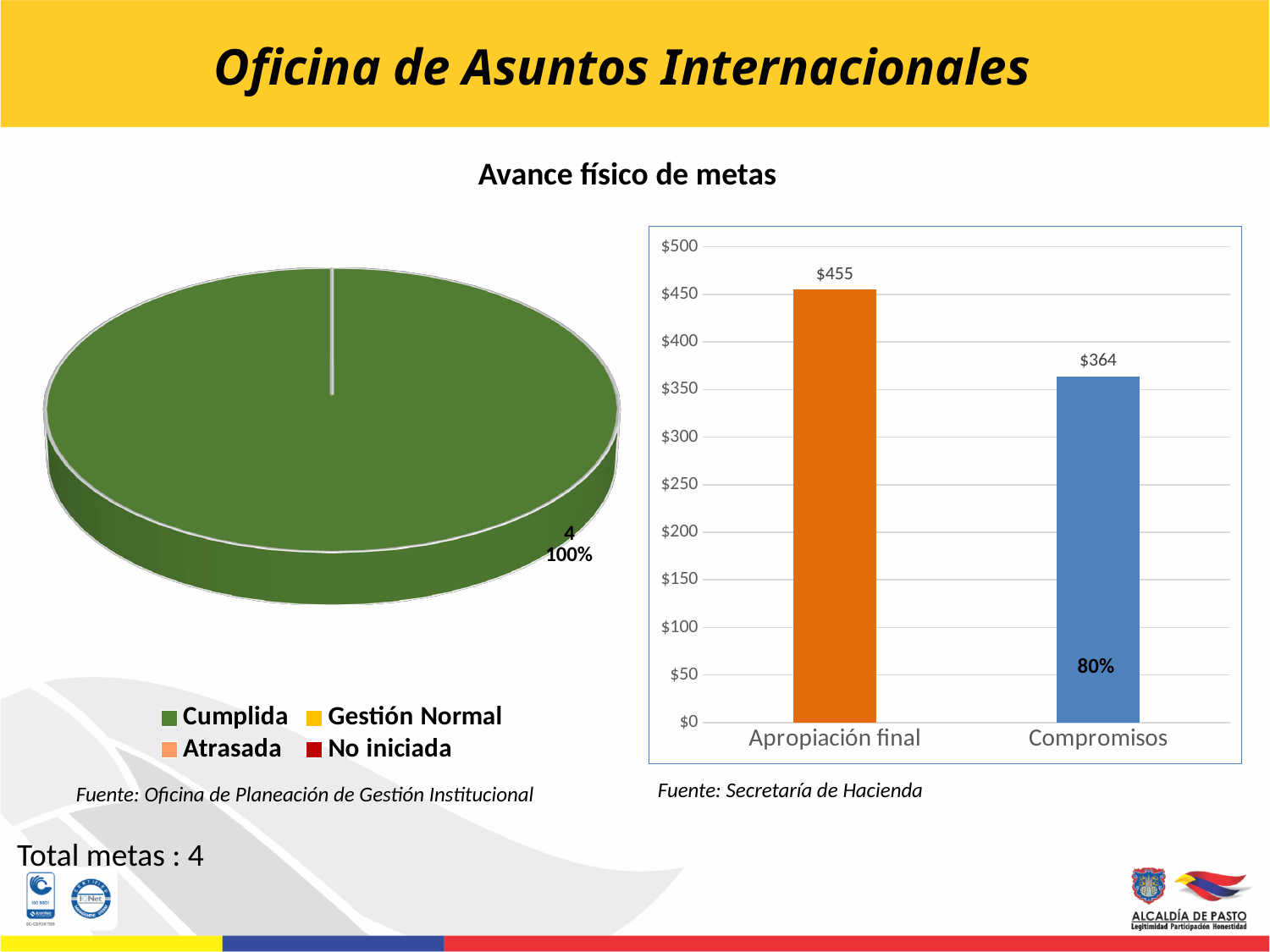
How many entries does the legend of the pie chart on the left list? 4 In the bar chart on the right, what is the value for Compromisos? $364 In the pie chart on the left, what value is labelled on the Cumplida slice? 4 In the bar chart on the right, is the value for Compromisos greater or less than $400? less In the bar chart on the right, how many categories are shown on the x axis? 2 In the bar chart on the right, what is the difference between Apropiación final and Compromisos? $91 What kind of chart is the chart on the right side of the slide? Bar chart In the pie chart on the left, what share does the Cumplida slice represent? 100% What kind of chart is the chart on the left side of the slide? Pie chart In the bar chart on the right, which category has the higher value, Apropiación final or Compromisos? Apropiación final In the bar chart on the right, what percentage label is shown on the Compromisos bar? 80% In the bar chart on the right, what is the value for Apropiación final? $455